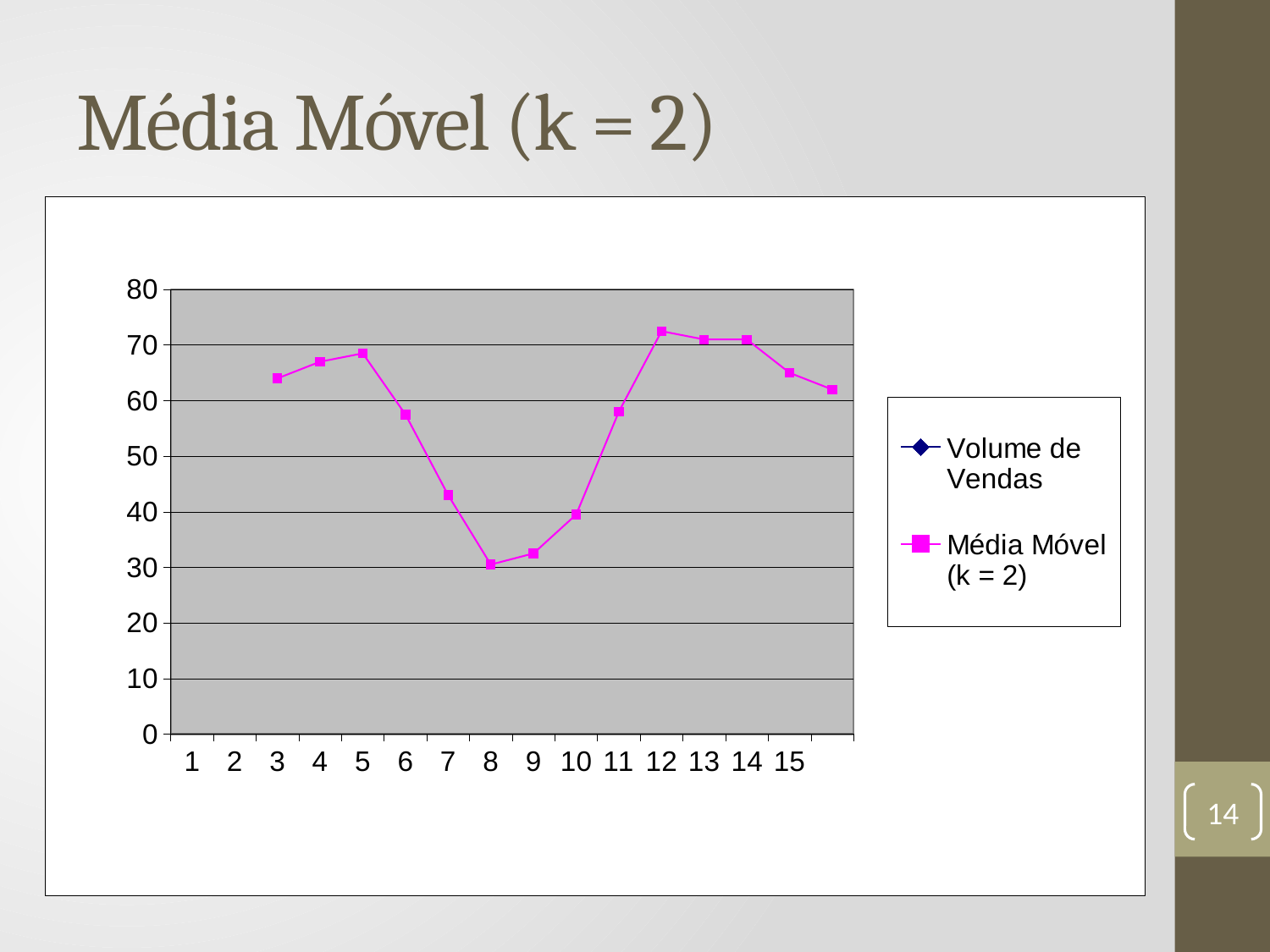
Is the Média Móvel (k = 2) value at x = 3 greater or less than 60? greater Does the Média Móvel (k = 2) line rise or fall between x = 5 and x = 8? fall What kind of chart is shown on the slide? line chart Is the Média Móvel (k = 2) value at x = 7 greater or less than 50? less What are the two series named in the legend? Volume de Vendas; Média Móvel (k = 2) Does the Média Móvel (k = 2) line rise or fall between x = 8 and x = 12? rise Which is larger for the Média Móvel (k = 2) series: the value at x = 12 or the value at x = 8? x = 12 How many series does the legend list? 2 Is the Média Móvel (k = 2) value at x = 15 greater or less than 60? greater What colour is the plotted Média Móvel (k = 2) line? magenta